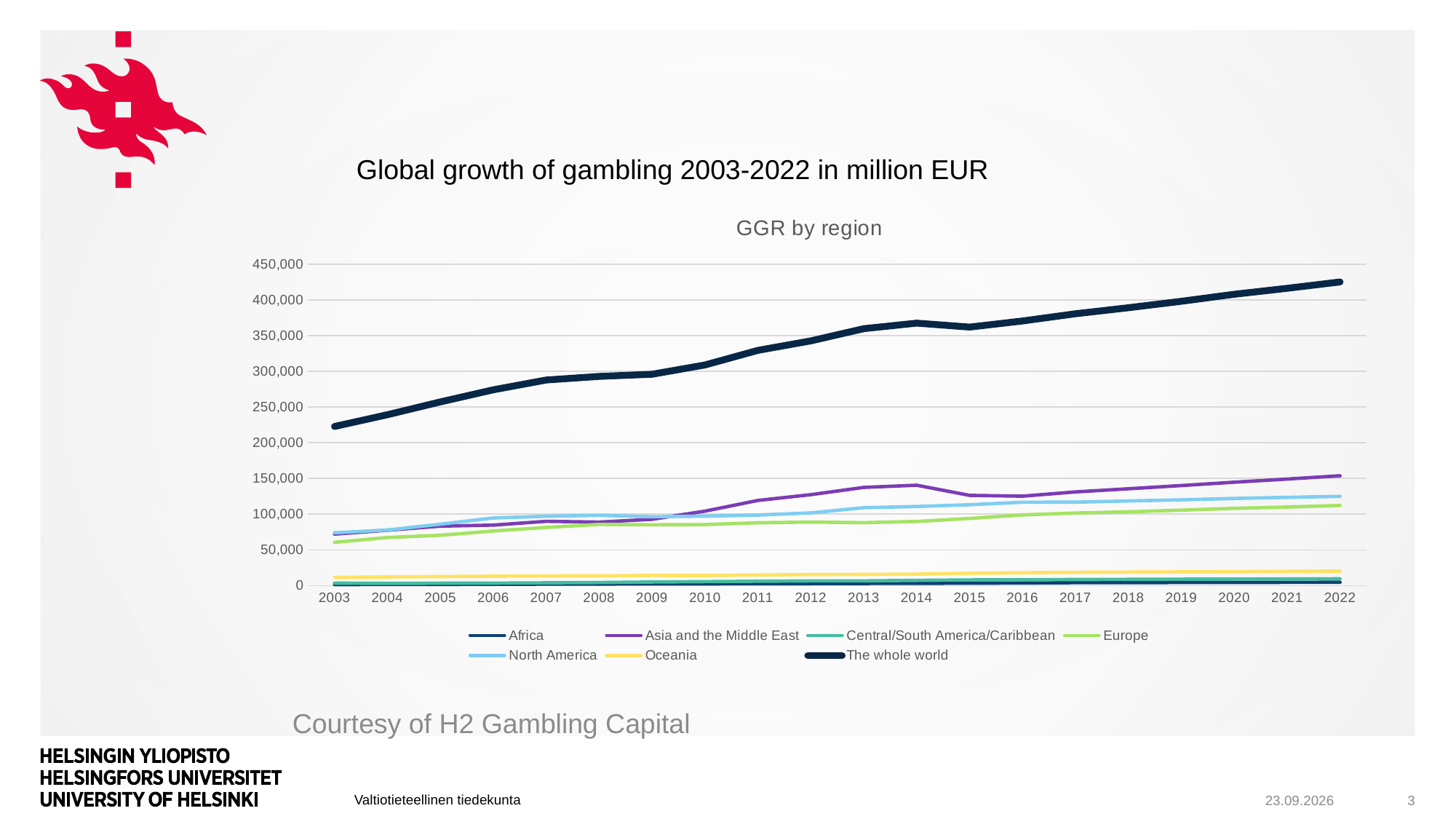
Is the value for The whole world in 2003 greater or less than 250,000? less How many series does the legend list? 7 Is the value for Oceania in 2022 greater or less than 50,000? less Does the value for Asia and the Middle East rise or fall between 2014 and 2015? fall What kind of chart is shown on the slide? line chart Among the regional series (excluding The whole world), which has the highest value in 2022? Asia and the Middle East Does the value for The whole world rise or fall from 2003 to 2022? rise How many years are shown on the x axis? 20 In 2022, which is larger: North America or Europe? North America Is the value for The whole world in 2022 greater or less than 400,000? greater Which series has the highest value in 2022? The whole world What is the title shown directly above the plot area? GGR by region